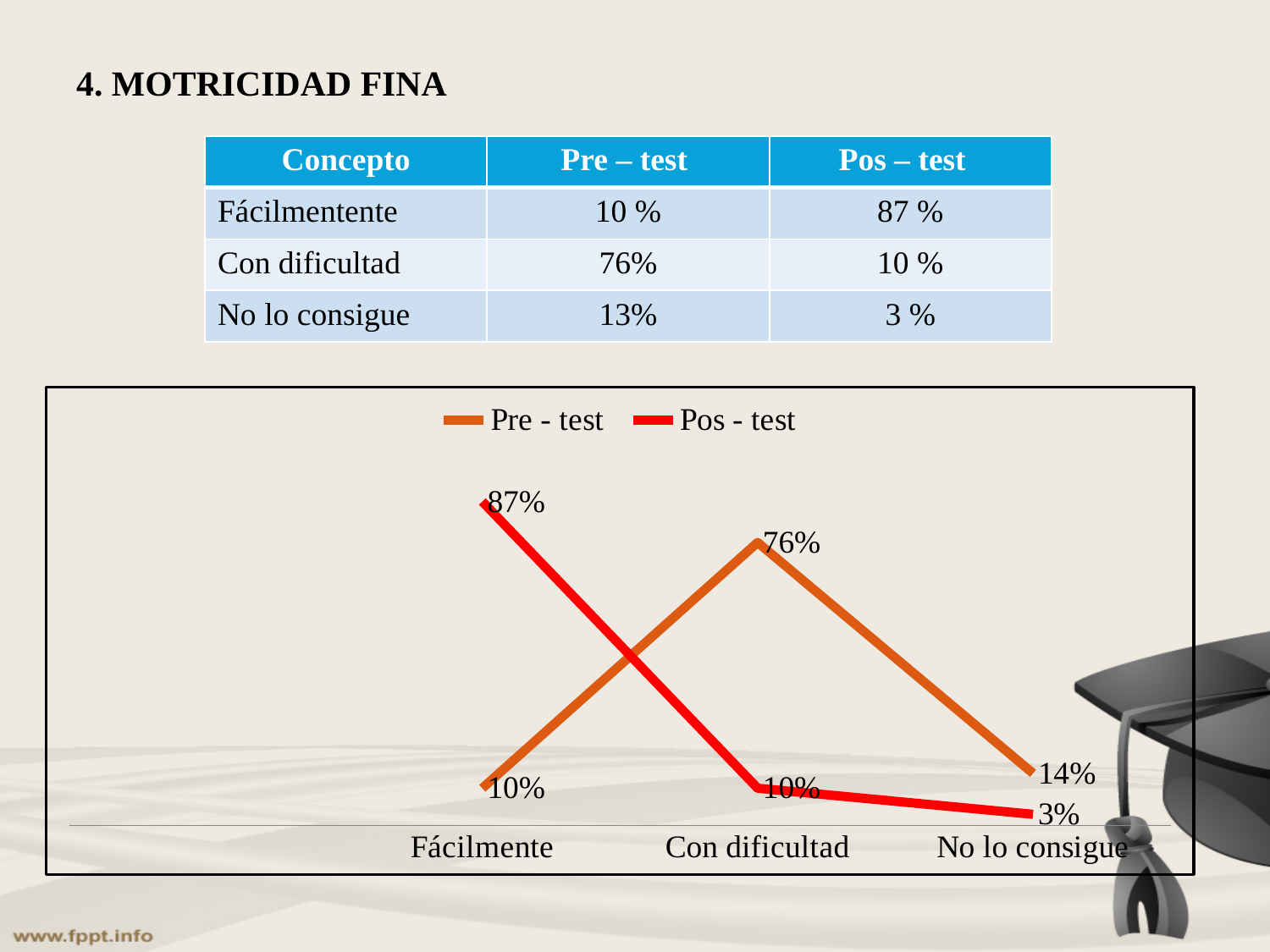
What is the Pre - test value for No lo consigue in the chart? 14% What is the Pos - test value for No lo consigue in the chart? 3% Which category has the lowest Pos - test value in the chart? No lo consigue How many categories are shown on the x axis of the chart? 3 What is the Pos - test value for Fácilmente in the chart? 87% For Con dificultad, which series has the larger value in the chart, Pre - test or Pos - test? Pre - test What is the difference between the Pos - test and Pre - test values for Fácilmente in the chart? 77% Does the Pos - test line rise or fall from Fácilmente to No lo consigue? Fall Which category has the highest Pre - test value in the chart? Con dificultad How many series does the chart legend list? 2 What is the Pre - test value for Con dificultad in the chart? 76% What type of chart is shown on the slide? Line chart